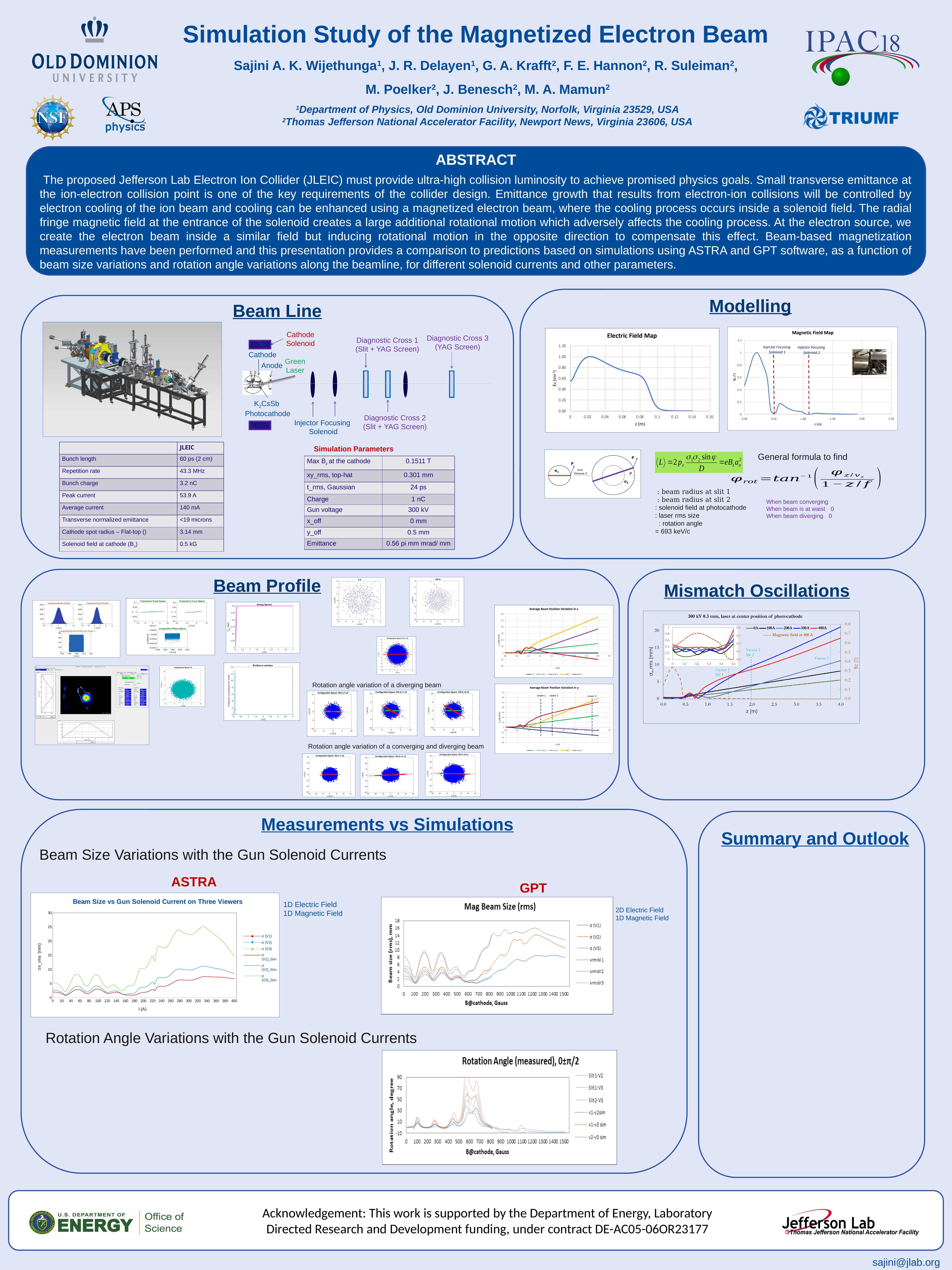
On the 'Beam Size vs Gun Solenoid Current on Three Viewers' chart, what is the label of the x axis? I (A) On the 'Rotation Angle (measured), 0±π/2' chart, is the highest rotation angle reached greater or less than 50 degrees? greater On the 'Mag Beam Size (rms)' chart, what is the label of the x axis? B@cathode, Gauss What kind of chart is the 'Beam Size vs Gun Solenoid Current on Three Viewers' chart in the Measurements vs Simulations section? Line chart On the 'Rotation Angle (measured), 0±π/2' chart, how many series does the legend list? 6 On the 'Electric Field Map' chart in the Modelling section, is the peak value of Ez greater or less than 0.80? greater On the 'Beam Size vs Gun Solenoid Current on Three Viewers' chart (ASTRA), how many series does the legend list? 6 On the 'Mag Beam Size (rms)' chart (GPT), how many series does the legend list? 6 On the 'Mag Beam Size (rms)' chart, is the value of σ(V1) at 1500 Gauss greater or less than 10? less On the 'Electric Field Map' chart, does the field value rise or fall between z = 0.10 and z = 0.16? fall